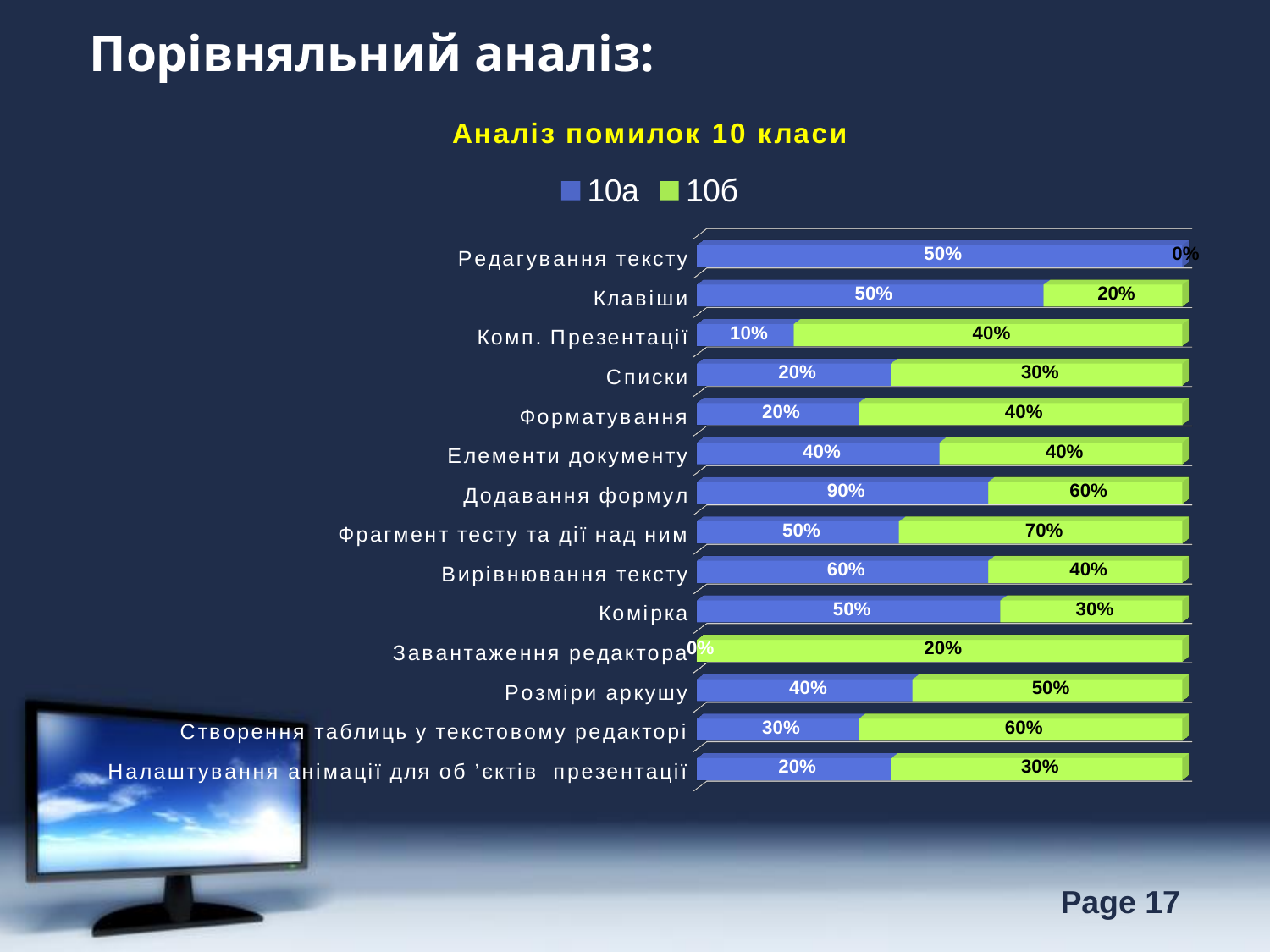
How many categories are shown on the chart? 14 Which category has the highest value for the 10а series? Додавання формул What kind of chart is shown on the slide? Stacked bar chart What is the value for 10а in the Додавання формул category? 90% In the Вирівнювання тексту category, which series has the larger value, 10а or 10б? 10а Which category has the highest value for the 10б series? Фрагмент тесту та дії над ним Which category has the lowest value for the 10а series? Завантаження редактора What is the value for 10б in the Фрагмент тесту та дії над ним category? 70% What is the difference between the 10а and 10б values in the Створення таблиць у текстовому редакторі category? 30% What is the value for 10б in the Редагування тексту category? 0% What is the value for 10а in the Комп. Презентації category? 10% How many series does the legend list? 2